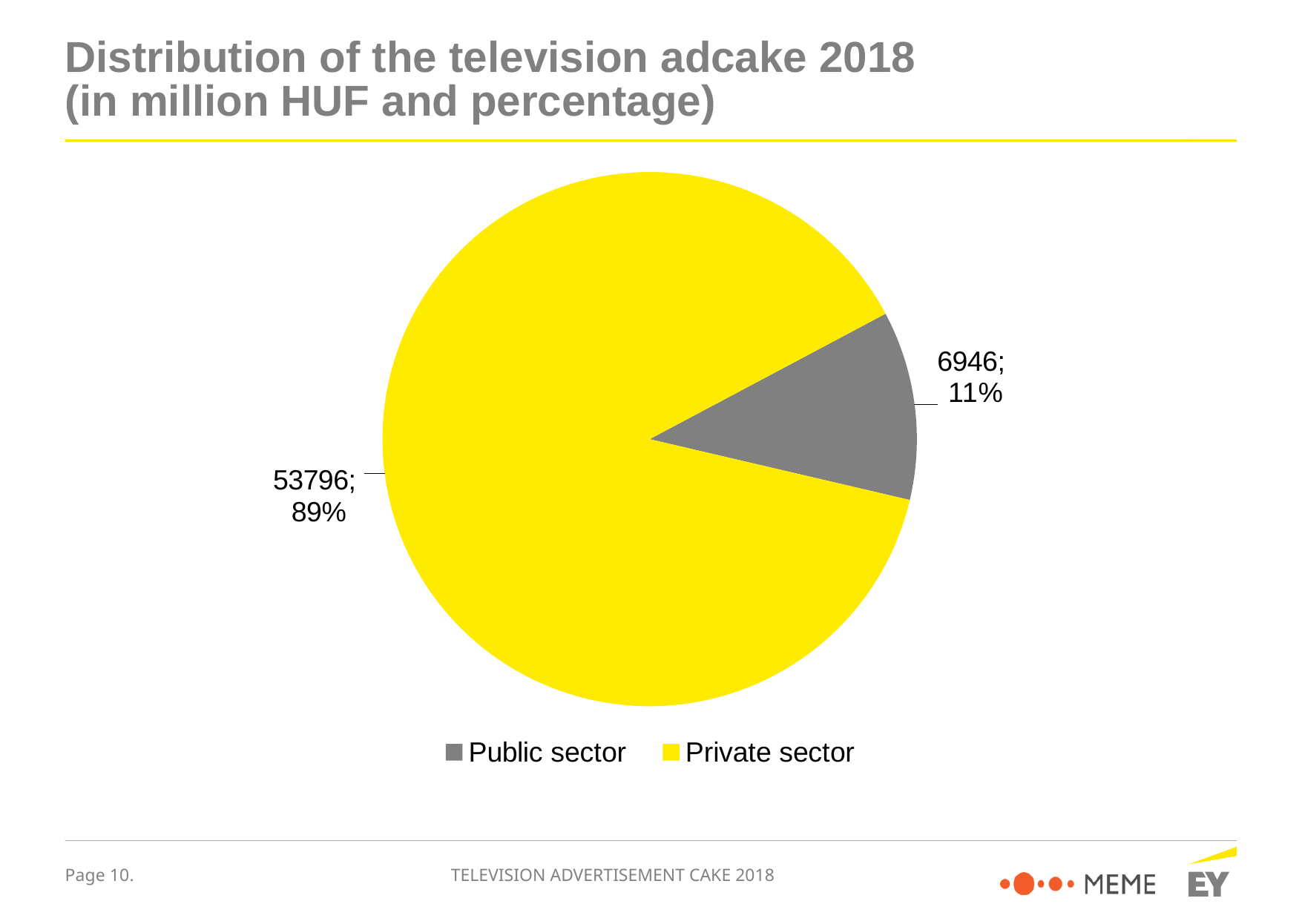
What is the total of the two slices in million HUF? 60742 What colour is the Private sector slice? Yellow Which sector has the largest slice of the pie? Private sector What is the value in million HUF for the Private sector? 53796 What kind of chart is shown on the slide? Pie chart What is the difference in million HUF between the Private sector and the Public sector? 46850 Which sector has the smallest slice of the pie? Public sector What share of the pie does the Private sector slice represent? 89% How many slices does the pie chart have? 2 What share of the pie does the Public sector slice represent? 11% Which is larger, the Public sector value or the Private sector value? Private sector What is the value in million HUF for the Public sector? 6946